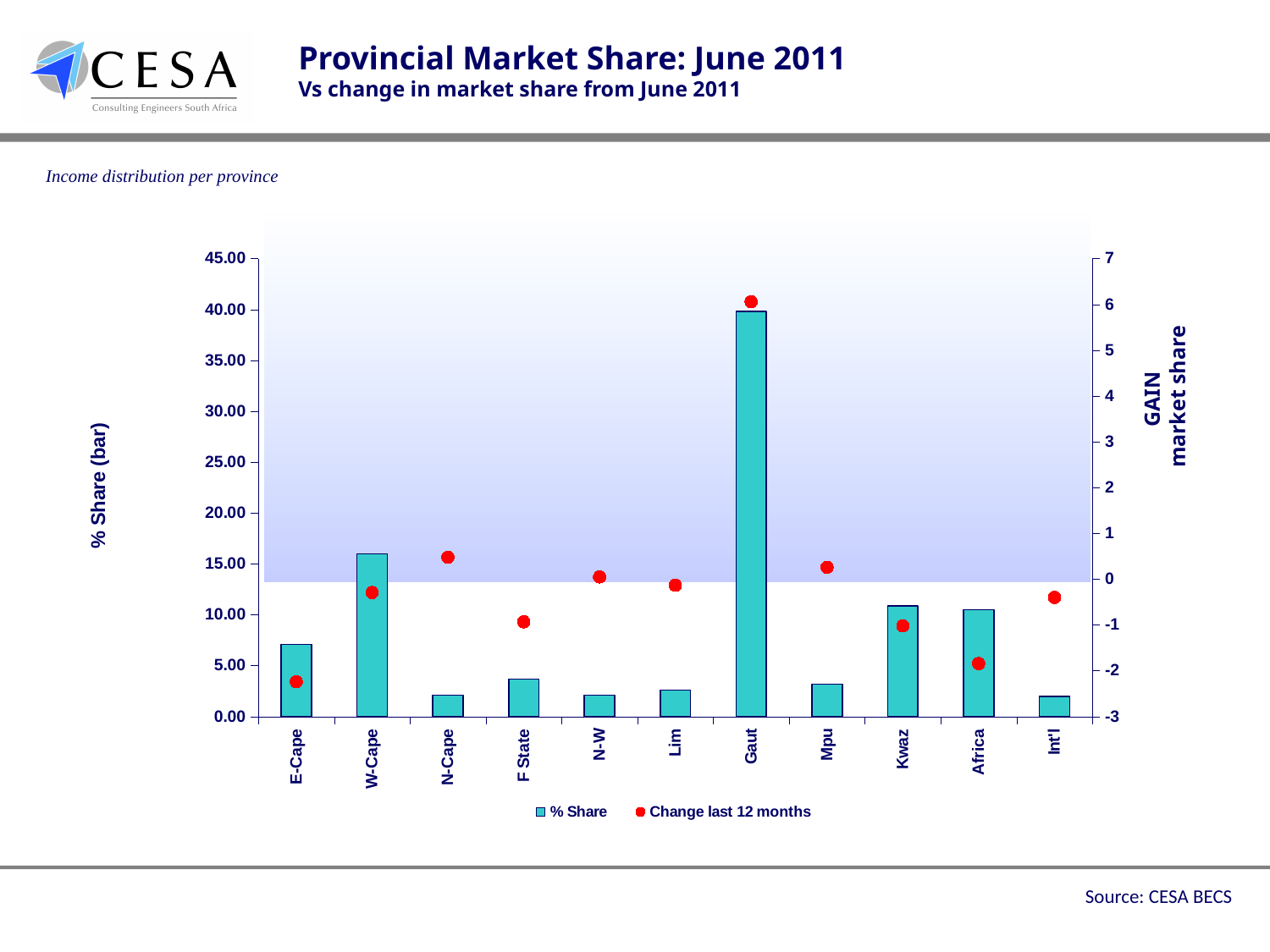
How many provinces/categories are shown on the x axis? 11 What kind of chart is used to show the % Share series? bar chart Which province has the highest % Share bar? Gaut What is the title of the right-hand vertical axis? GAIN market share How many series does the legend list? 2 Is the Change last 12 months marker for Gaut greater or less than 5 on the right axis? greater Is the Change last 12 months marker for E-Cape greater or less than -2 on the right axis? less Is the % Share bar for W-Cape greater or less than 10.00? greater Which has the larger % Share bar, W-Cape or E-Cape? W-Cape